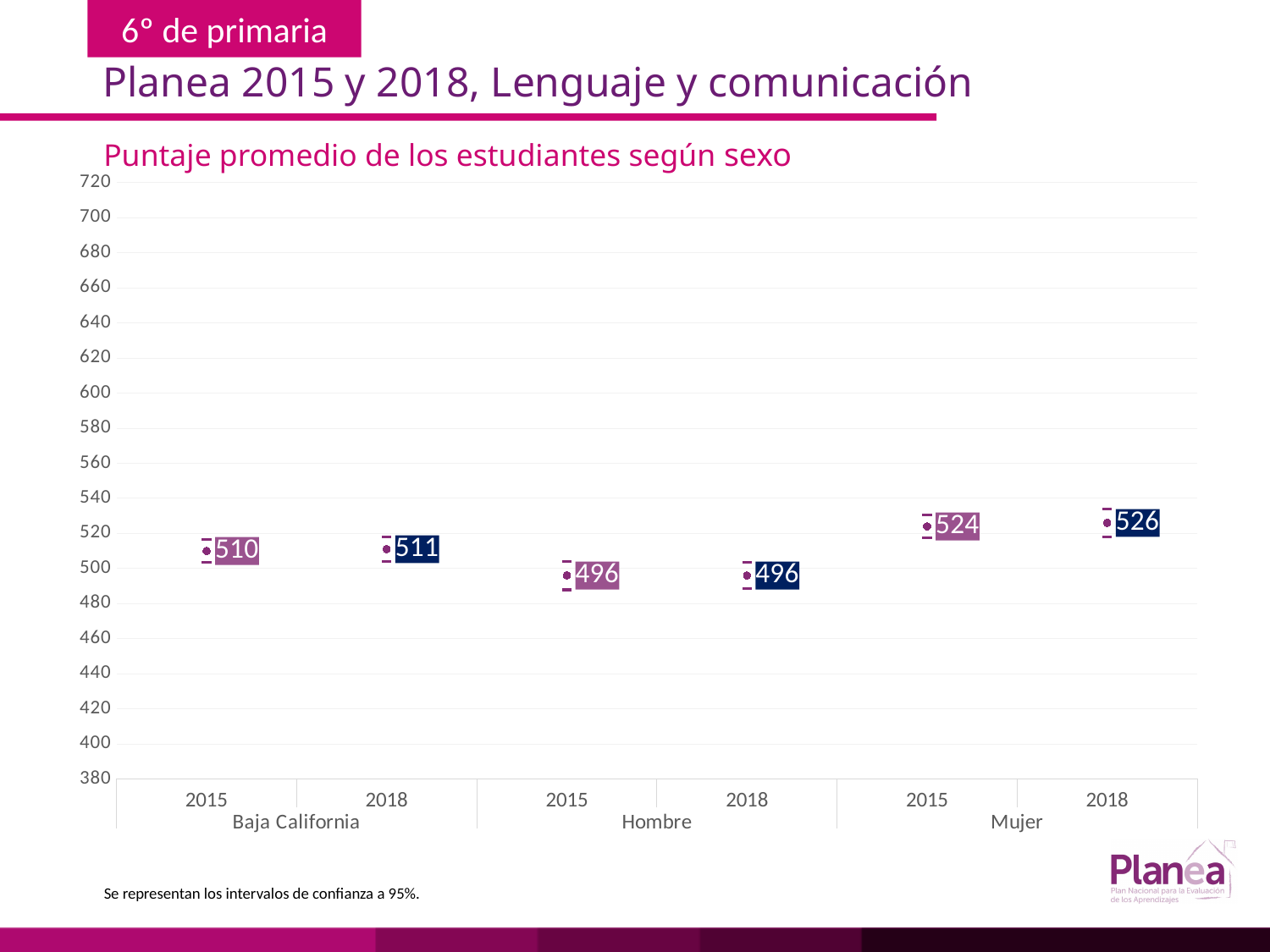
What is the title of the chart? Puntaje promedio de los estudiantes según sexo What is the difference between the Mujer and Hombre scores in 2018? 30 How many data points are plotted on the chart? 6 Which group and year has the highest average score? Mujer 2018 What is the average score for Hombre in 2018? 496 What do the small bars around each point represent, according to the note on the slide? Intervalos de confianza a 95% What is the average score for Baja California in 2015? 510 What is the difference between the Baja California scores in 2018 and 2015? 1 Is the Hombre score in 2015 greater or less than 500? less What is the average score for Mujer in 2015? 524 What is the average score for Mujer in 2018? 526 Which is larger, the Mujer score in 2015 or the Baja California score in 2015? Mujer 2015